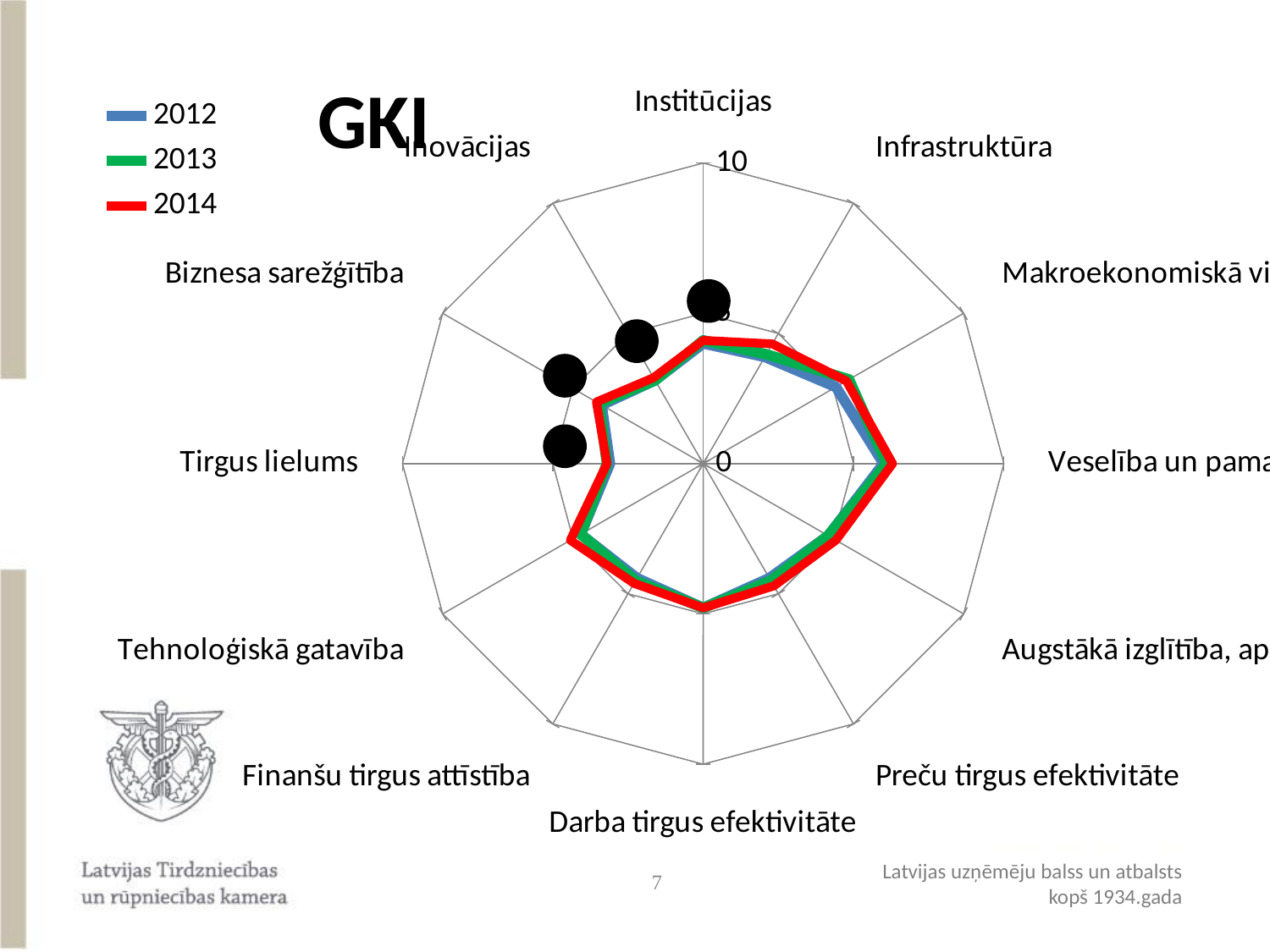
Is the 2014 value for Tirgus lielums greater or less than 5? less Which category has the highest 2014 value? Veselība un pama... How many categories (axes) does the radar chart have? 12 What is the title of the chart? GKI How many series does the legend list? 3 Which years are listed in the legend? 2012, 2013, 2014 Which is larger for 2014: Darba tirgus efektivitāte or Tirgus lielums? Darba tirgus efektivitāte Is the 2014 value for Institūcijas greater or less than 5? less Is the 2014 value for Inovācijas greater or less than 5? less What is the maximum value shown on the radial axis? 10 What kind of chart is shown on the slide? Radar chart